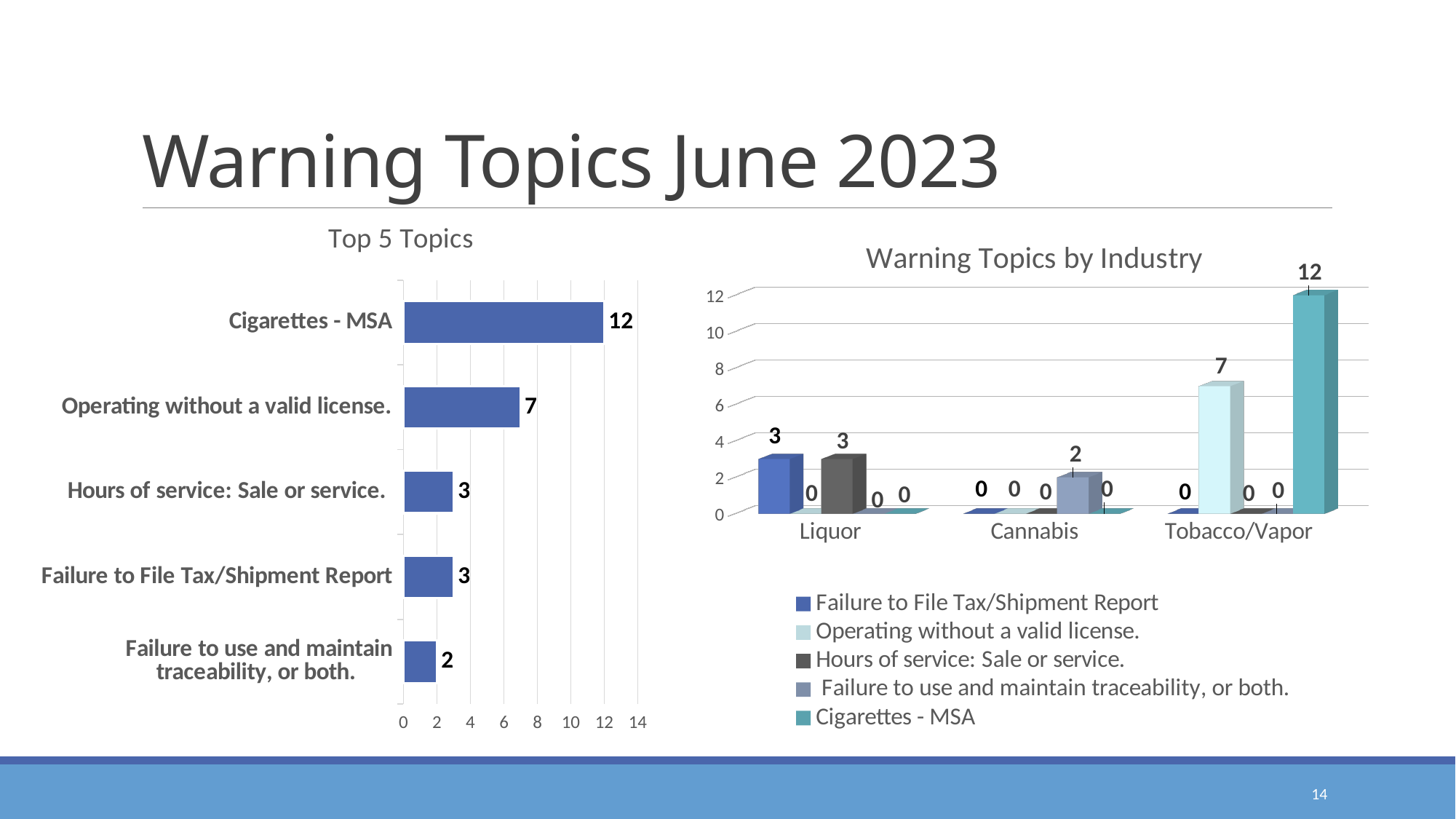
In the 'Warning Topics by Industry' chart, what is the value for Cigarettes - MSA in Tobacco/Vapor? 12 In the 'Top 5 Topics' chart, which topic has the lowest value? Failure to use and maintain traceability, or both. In the 'Warning Topics by Industry' chart, what is the value for Failure to use and maintain traceability, or both. in Cannabis? 2 What kind of chart is the 'Top 5 Topics' chart? bar chart In the 'Warning Topics by Industry' chart, which is larger: Operating without a valid license. in Tobacco/Vapor or Hours of service: Sale or service. in Liquor? Operating without a valid license. in Tobacco/Vapor In the 'Top 5 Topics' chart, how many topics are shown? 5 In the 'Top 5 Topics' chart, what is the value for Cigarettes - MSA? 12 In the 'Top 5 Topics' chart, what is the value for Operating without a valid license.? 7 In the 'Warning Topics by Industry' chart, how many industries are shown on the x axis? 3 In the 'Warning Topics by Industry' chart, what is the value for Failure to File Tax/Shipment Report in Liquor? 3 In the 'Top 5 Topics' chart, what is the difference between Cigarettes - MSA and Operating without a valid license.? 5 In the 'Warning Topics by Industry' chart, how many series does the legend list? 5